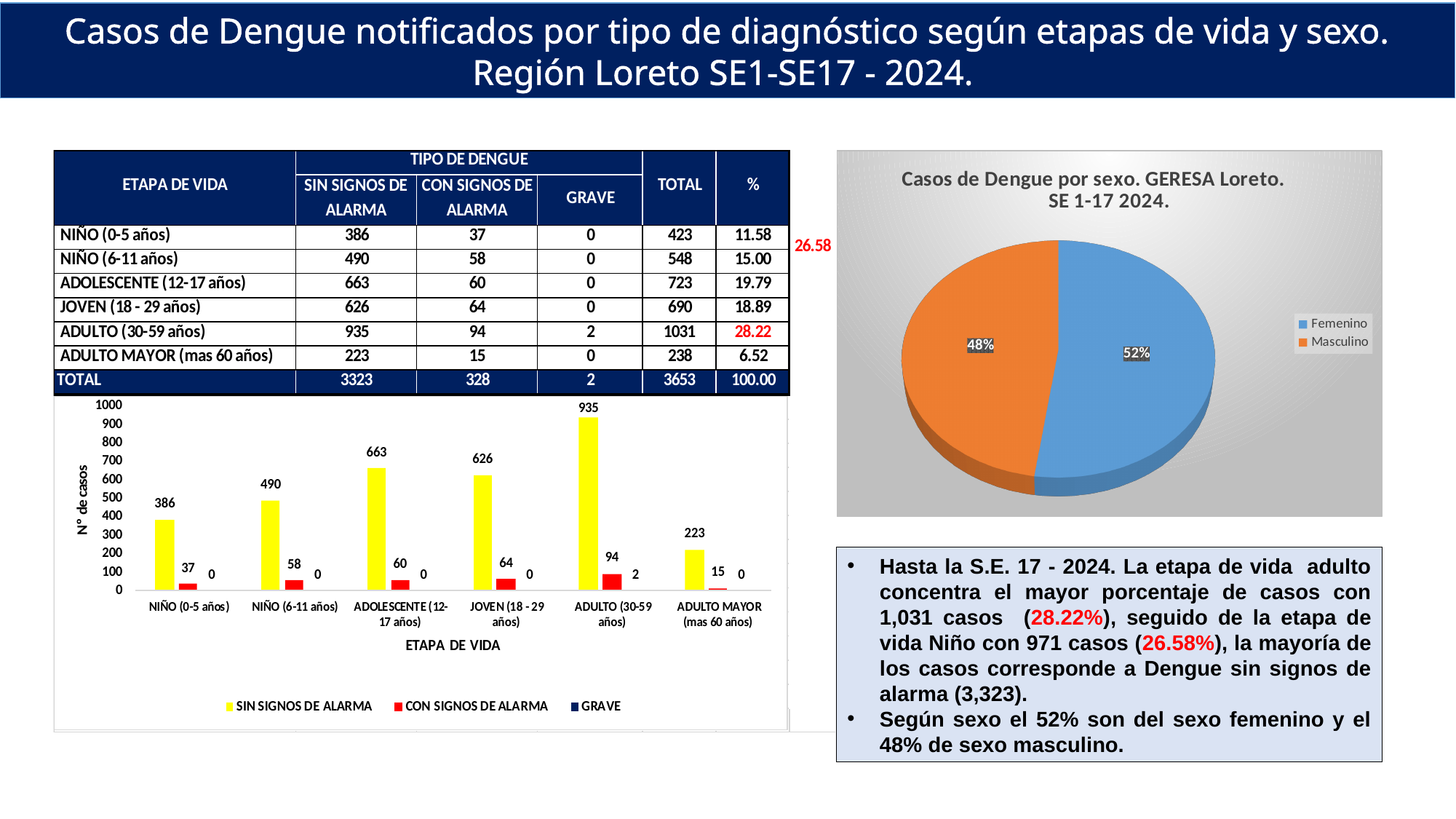
In the bar chart at the bottom left, which is larger: CON SIGNOS DE ALARMA for NIÑO (6-11 años) or for ADOLESCENTE (12-17 años)? ADOLESCENTE (12-17 años) In the bar chart at the bottom left, which age group has the highest SIN SIGNOS DE ALARMA value? ADULTO (30-59 años) In the bar chart at the bottom left, what is the value of GRAVE for ADULTO (30-59 años)? 2 In the bar chart at the bottom left, what is the value of SIN SIGNOS DE ALARMA for ADULTO (30-59 años)? 935 In the bar chart at the bottom left, how many series does the legend list? 3 In the pie chart on the right, which colour represents Masculino? Orange In the bar chart at the bottom left, what is the difference between the SIN SIGNOS DE ALARMA values for ADOLESCENTE (12-17 años) and JOVEN (18 - 29 años)? 37 In the pie chart on the right, what share of cases is Femenino? 52% In the bar chart at the bottom left, what is the value of CON SIGNOS DE ALARMA for JOVEN (18 - 29 años)? 64 In the bar chart at the bottom left, which age group has the lowest SIN SIGNOS DE ALARMA value? ADULTO MAYOR (mas 60 años) In the bar chart at the bottom left, how many age groups are shown on the x axis? 6 What kind of chart is the chart titled 'Casos de Dengue por sexo. GERESA Loreto. SE 1-17 2024.'? Pie chart